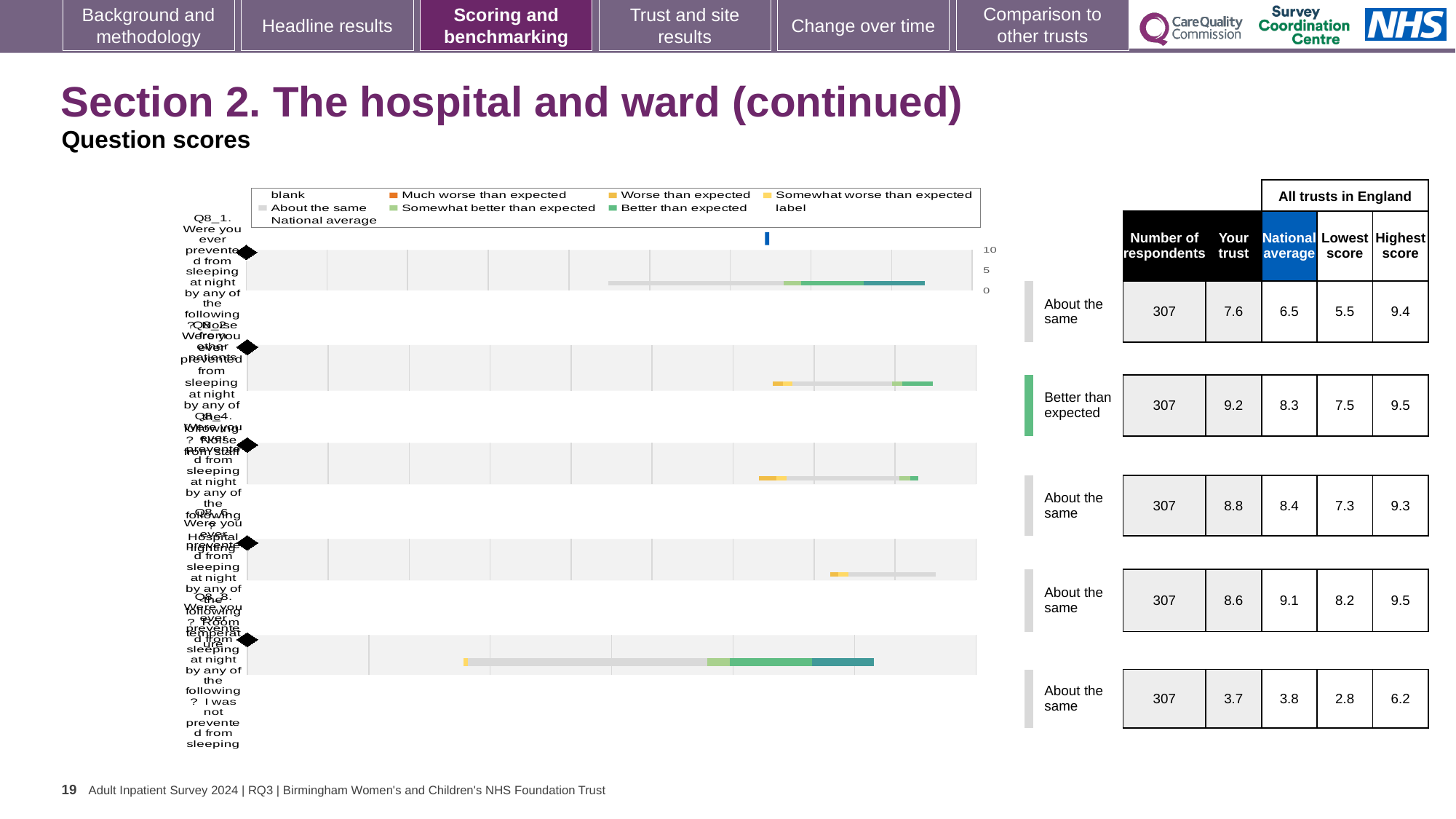
Which row has the lowest 'Your trust' score? the fifth row, 3.7 What kind of chart is shown on the slide? bar chart What is the number of respondents for the third row? 307 How many entries does the chart legend list? 9 For the fourth row, which is larger: the 'Your trust' score or the national average? national average (9.1) Which row has the highest 'Your trust' score? the second row (Better than expected), 9.2 Which benchmark category is shown for the second row of the chart? Better than expected What is the national average for the first row of the chart? 6.5 What is the 'Your trust' score for the second row (Better than expected)? 9.2 What is the difference between the highest and lowest 'Your trust' scores? 5.5 How many rows of the chart are labelled 'About the same'? 4 How many question rows (bars) does the chart show? 5